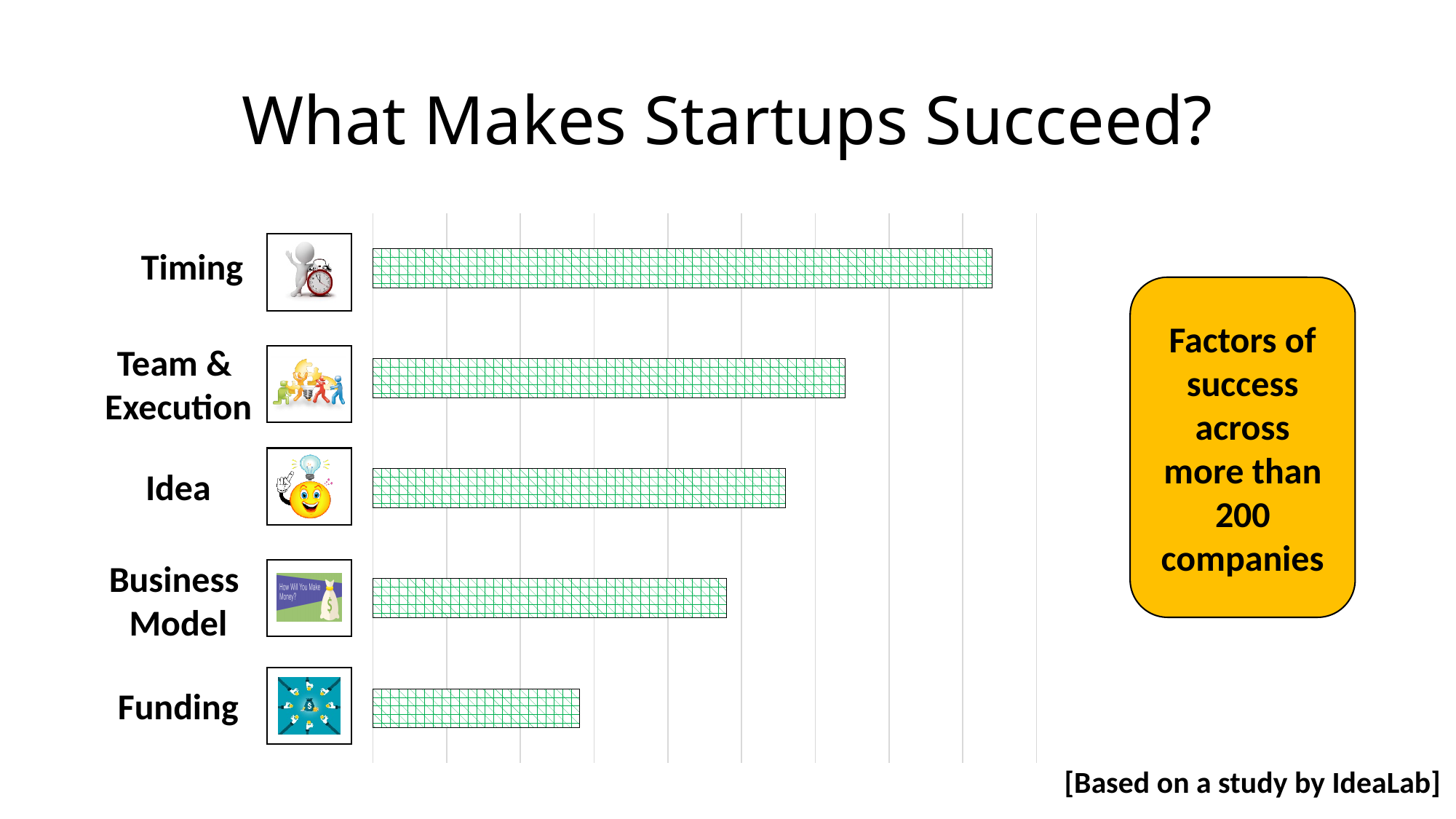
Which has the larger value, Business Model or Funding? Business Model Which has the larger value, Timing or Idea? Timing What kind of chart is shown on the slide? Bar chart Which has the larger value, Team & Execution or Business Model? Team & Execution Which category has the shortest bar in the chart? Funding How many categories are plotted in the chart? 5 Which category has the longest bar in the chart? Timing What is the title of the slide containing the chart? What Makes Startups Succeed? Do the bar lengths increase or decrease going from the top category to the bottom category? Decrease Are the bars in the chart oriented horizontally or vertically? Horizontally Which category is ranked second highest in the chart? Team & Execution